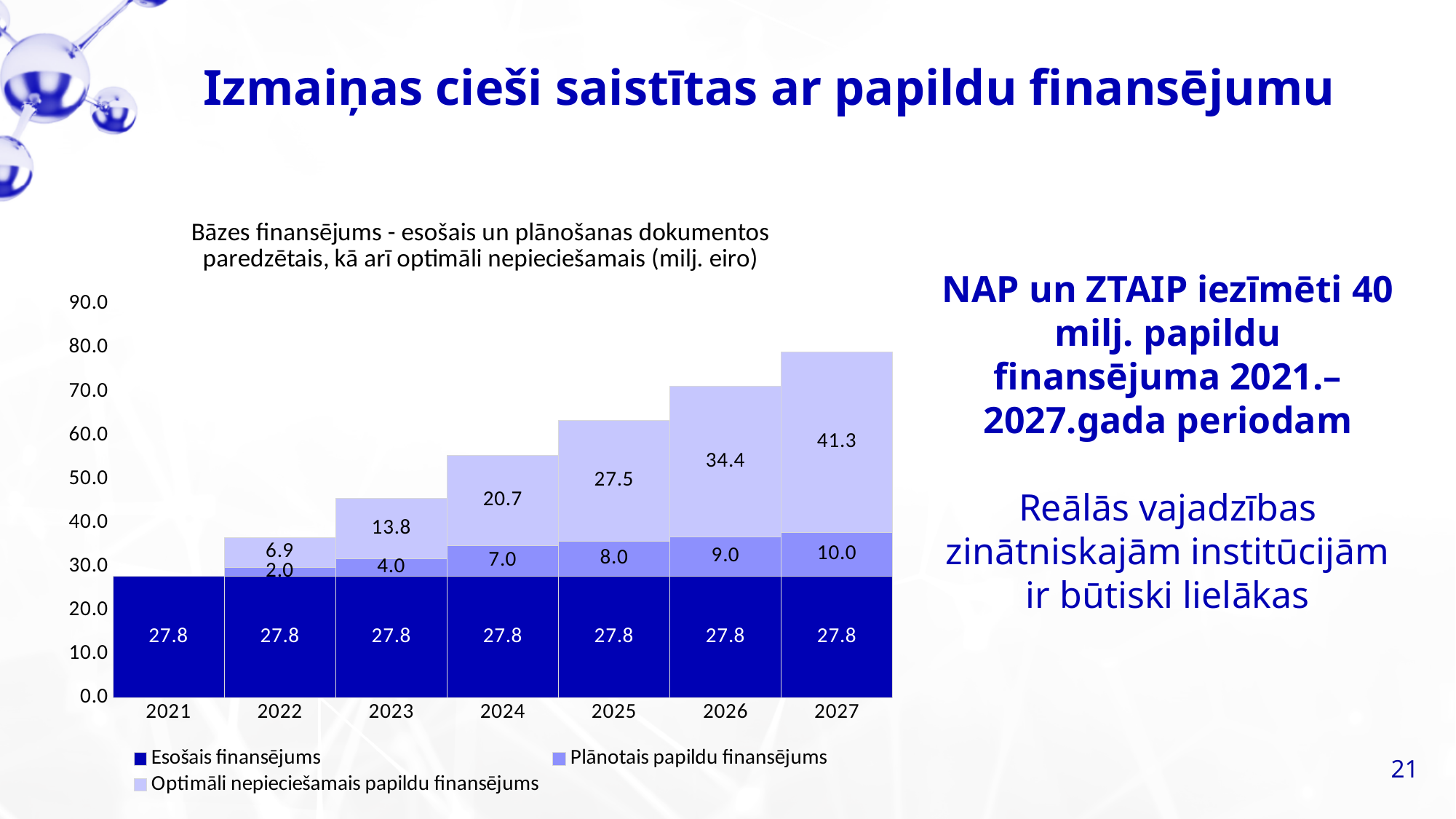
What is the value of Optimāli nepieciešamais papildu finansējums in 2026? 34.4 How many series does the legend list? 3 Does Optimāli nepieciešamais papildu finansējums rise or fall from 2022 to 2027? Rise In which year is Plānotais papildu finansējums lowest among the years where it is shown? 2022 What is the value of Plānotais papildu finansējums in 2025? 8.0 Which is larger in 2024: Plānotais papildu finansējums or Optimāli nepieciešamais papildu finansējums? Optimāli nepieciešamais papildu finansējums How many years are shown on the x axis? 7 What is the difference between Optimāli nepieciešamais papildu finansējums in 2027 and in 2023? 27.5 What is the value of Esošais finansējums in 2024? 27.8 What is the total of the stacked bar for 2027? 79.1 In which year is Optimāli nepieciešamais papildu finansējums highest? 2027 What type of chart is shown on the slide? Stacked bar chart